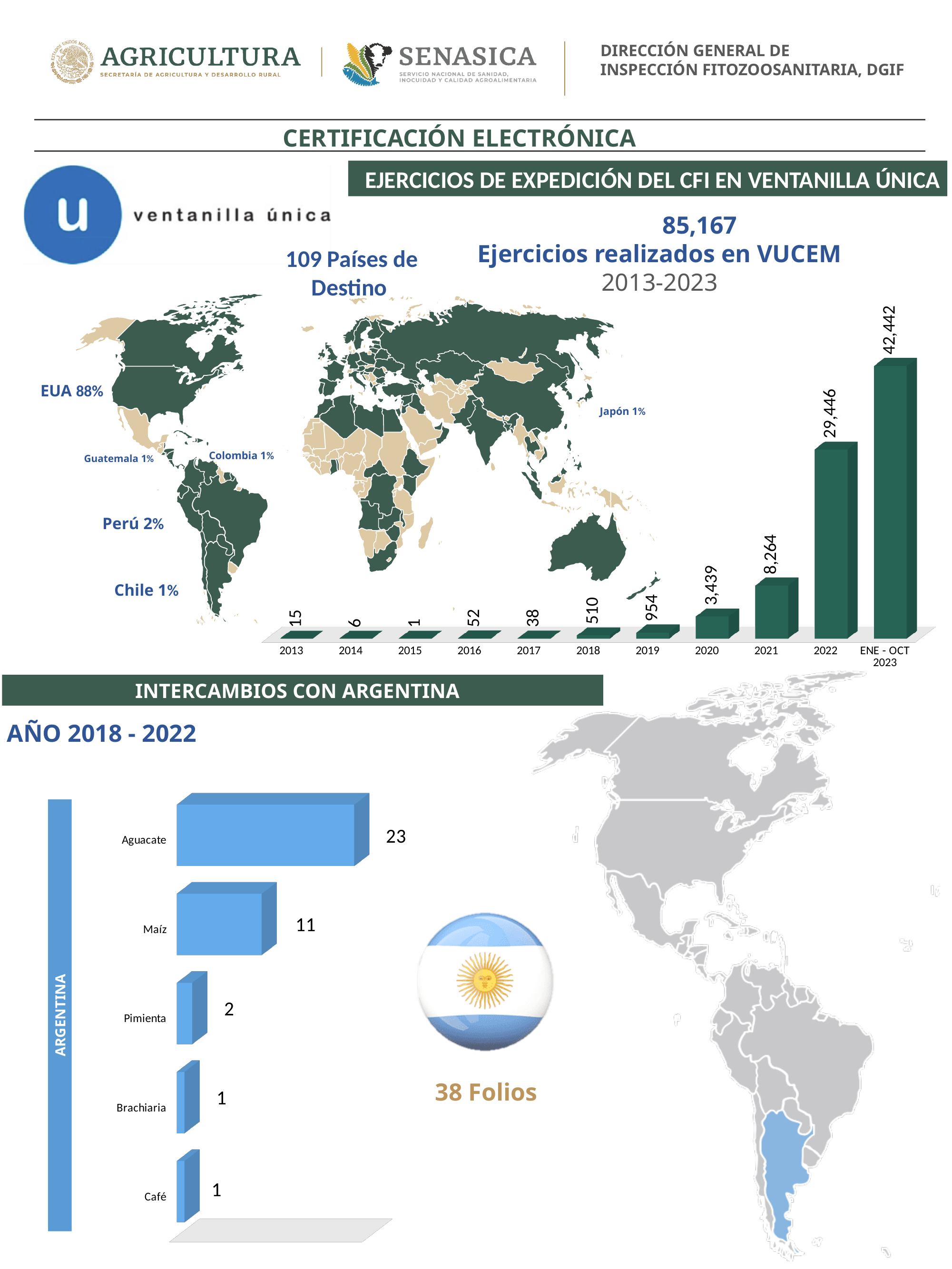
In the 'Ejercicios realizados en VUCEM 2013-2023' bar chart, what is the value for 2022? 29,446 In the 'Ejercicios realizados en VUCEM 2013-2023' bar chart, which year has the lowest value? 2015 In the 'Ejercicios realizados en VUCEM 2013-2023' bar chart, what is the difference between the values for 2021 and 2020? 4,825 In the 'Intercambios con Argentina' bar chart, which category has the highest value? Aguacate In the 'Ejercicios realizados en VUCEM 2013-2023' bar chart, which is larger, the value for 2016 or the value for 2017? 2016 In the 'Ejercicios realizados en VUCEM 2013-2023' bar chart, which period has the highest value? ENE - OCT 2023 In the 'Ejercicios realizados en VUCEM 2013-2023' bar chart, what is the value for ENE - OCT 2023? 42,442 How many categories are shown in the 'Intercambios con Argentina' bar chart? 5 What kind of chart is the 'Ejercicios realizados en VUCEM 2013-2023' chart? Bar chart In the 'Intercambios con Argentina' bar chart, what is the difference between the values for Aguacate and Maíz? 12 How many periods are shown on the x axis of the 'Ejercicios realizados en VUCEM 2013-2023' bar chart? 11 In the 'Intercambios con Argentina' bar chart, what is the value for Maíz? 11